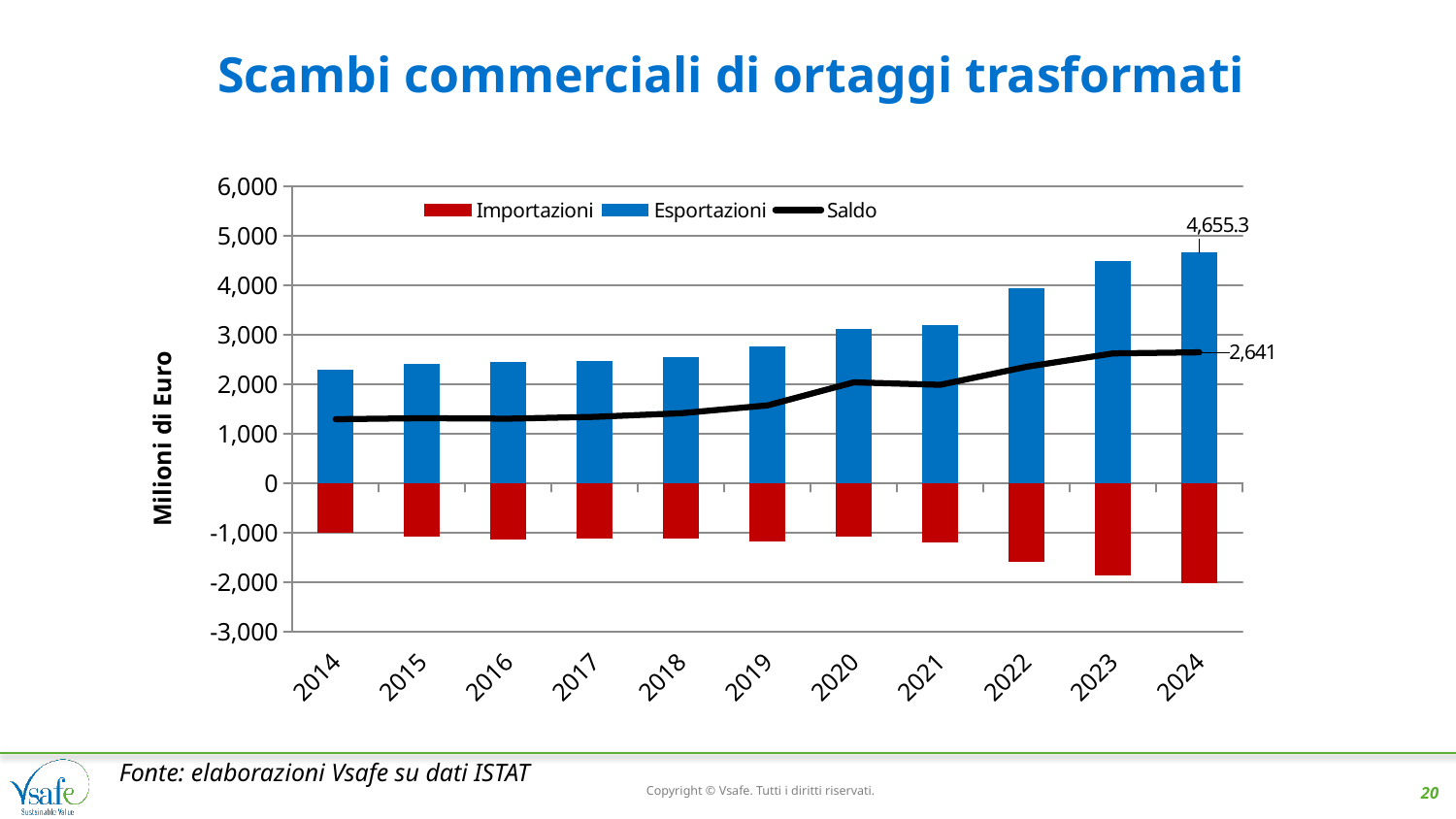
Is the value for Saldo in 2014 greater or less than 2,000? less What is the value of Saldo in 2024? 2,641 Do Esportazioni rise or fall from 2014 to 2024? Rise How many series does the legend list? 3 In which year is the Importazioni bar largest (most negative)? 2024 Is the value for Esportazioni in 2022 greater or less than 3,000? greater In which year are Esportazioni highest? 2024 What is the value of Esportazioni in 2024? 4,655.3 What kind of chart is this? Bar chart with a line What is the title of the y axis? Milioni di Euro How many years are shown on the x axis? 11 Which year has higher Esportazioni, 2020 or 2023? 2023